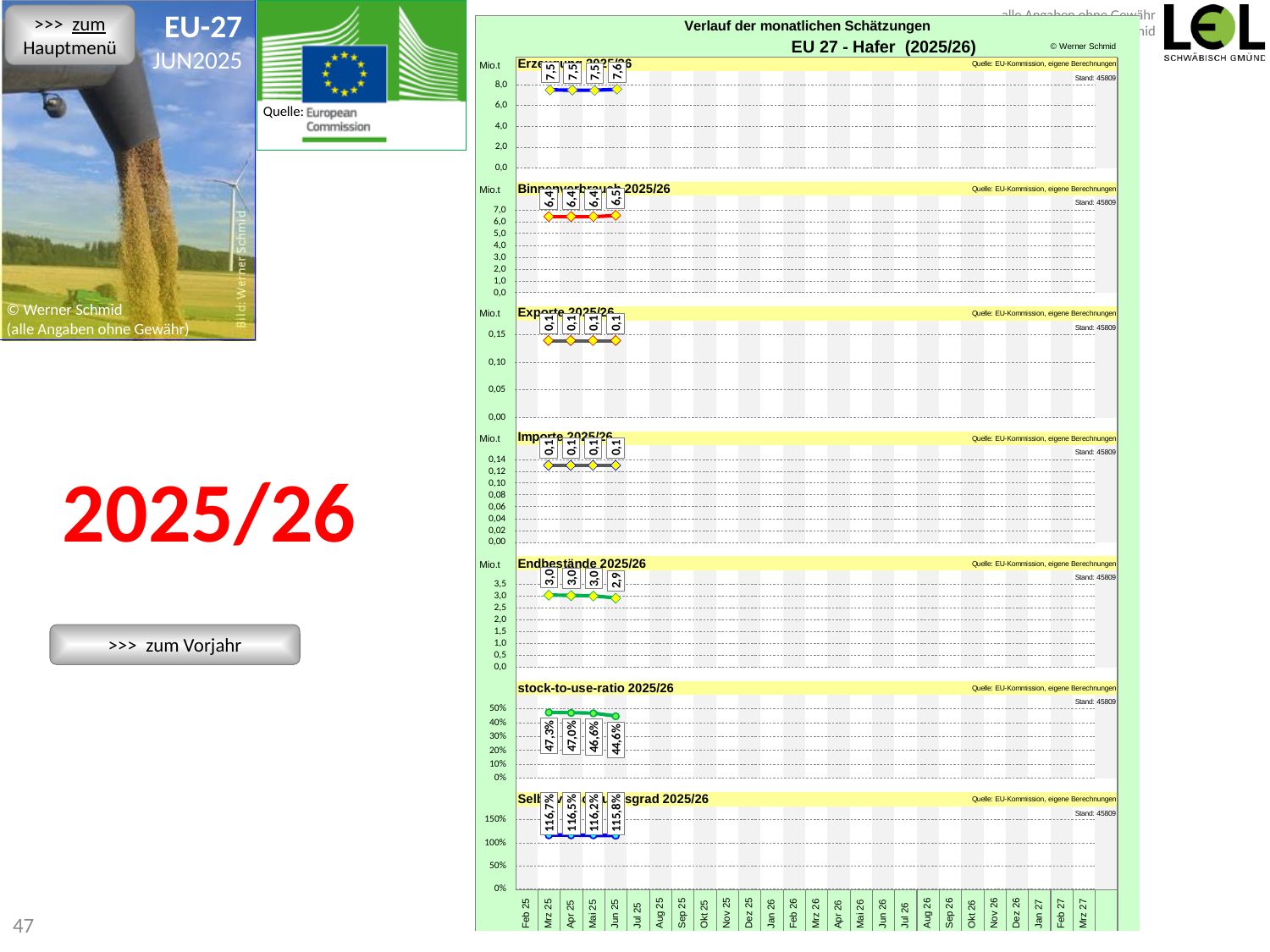
In the 'stock-to-use-ratio 2025/26' chart, do the values rise or fall from left to right? fall In the 'Binnenverbrauch 2025/26' chart, is the last data point larger or smaller than the first data point? larger In the 'stock-to-use-ratio 2025/26' chart, what is the value of the first data point? 47,3% What commodity and marketing year does the chart panel's title refer to? EU 27 - Hafer (2025/26) In the 'Erzeugung 2025/26' chart, how many data points are plotted? 4 In the 'Endbestände 2025/26' chart, what is the value of the last data point? 2,9 What kind of chart is used in the 'Erzeugung 2025/26' panel? line chart In the 'stock-to-use-ratio 2025/26' chart, what is the highest value shown? 47,3% In the 'Erzeugung 2025/26' chart, what is the value of the last (most recent) data point? 7,6 In the 'Erzeugung 2025/26' chart, what is the difference between the last data point and the first data point? 0,1 In the 'Exporte 2025/26' chart, what value is shown for each data point? 0,1 In the 'Selbstversorgungsgrad 2025/26' chart, what is the value of the last data point? 115,8%